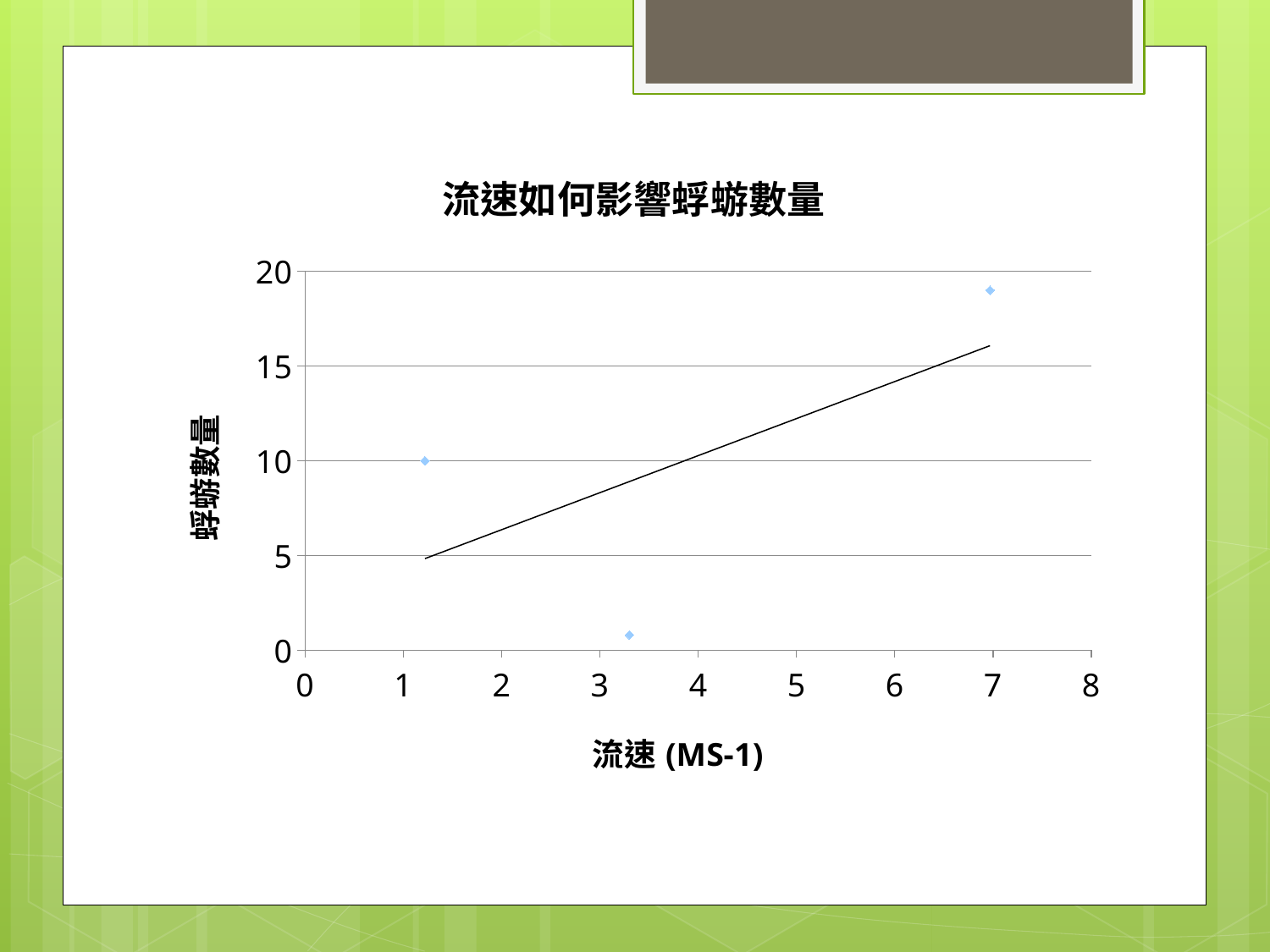
What kind of chart is shown on the slide? scatter chart Which data point has the lowest mayfly count: the one at a flow speed of about 1, about 3, or about 7? about 3 How many data points are plotted on the chart? 3 Does the trend line on the chart rise or fall as flow speed (流速) increases? rises What is the title of the chart? 流速如何影響蜉蝣數量 Which data point has the highest mayfly count: the one at a flow speed of about 1, about 3, or about 7? about 7 Is the mayfly count (蜉蝣數量) for the data point at a flow speed of about 3 greater or less than 5? less Which has the larger mayfly count: the data point at a flow speed of about 1 or the one at about 3? the one at about 1 Is the mayfly count (蜉蝣數量) for the data point at a flow speed of about 7 greater or less than 15? greater What is the mayfly count (蜉蝣數量) for the data point at a flow speed of about 1? 10 What is the label of the x axis? 流速 (MS-1) Is the mayfly count (蜉蝣數量) for the data point at a flow speed of about 1 greater or less than 5? greater